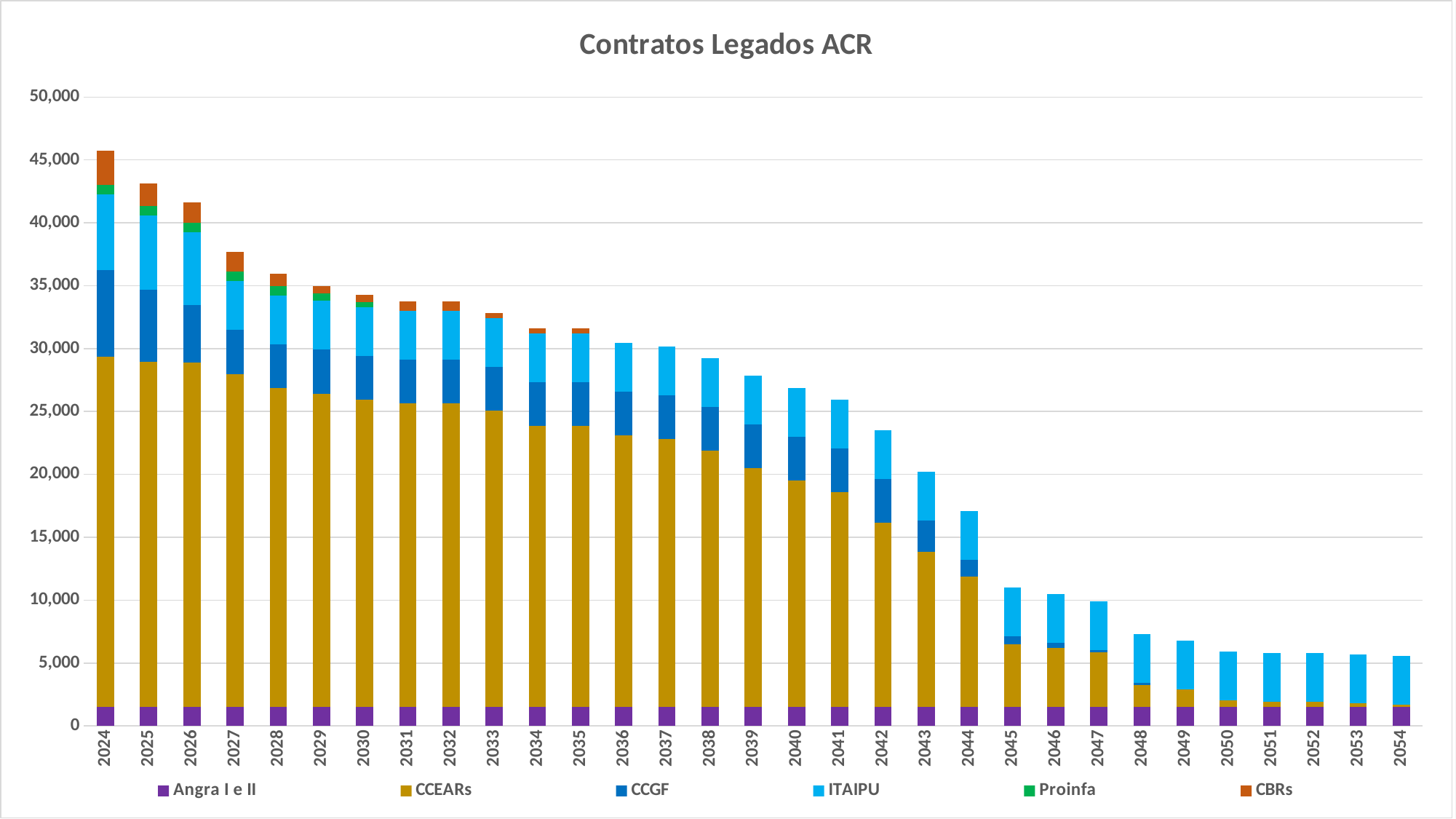
Which year has the highest total stacked bar? 2024 What is the title of the chart? Contratos Legados ACR How many series does the legend list? 6 What type of chart is shown on the slide? Stacked bar chart Is the total value for 2044 greater or less than 20,000? less Which year has a larger total stacked bar, 2035 or 2045? 2035 Do the total values rise or fall from 2024 to 2054? Fall How many years are shown along the x axis? 31 Is the total value for 2040 greater or less than 25,000? greater Which series is plotted at the bottom of each stacked bar? Angra I e II Is the total value for 2024 greater or less than 40,000? greater Which year has the lowest total stacked bar? 2054